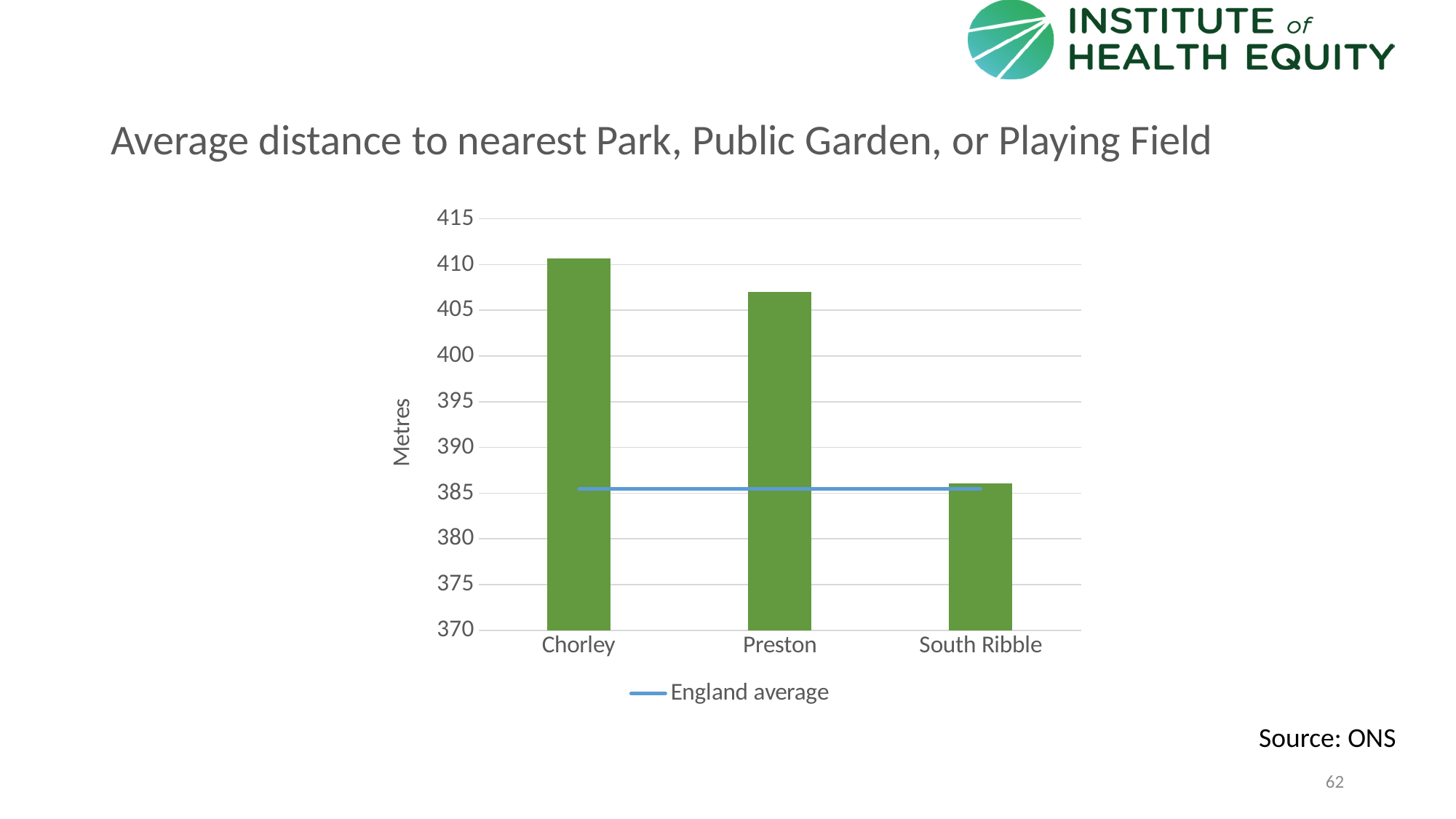
Do the bar values rise or fall moving from Chorley to South Ribble along the x axis? Fall Is the value for South Ribble greater or less than 390? less Which has the larger average distance, Preston or South Ribble? Preston How many local areas are plotted as bars in the chart? 3 Which area has the lowest average distance to the nearest park, public garden, or playing field? South Ribble Is the value for Preston greater or less than 410? less Is the value for Chorley greater or less than 405? greater What kind of chart is shown on the slide? Bar chart How many entries does the chart legend list? 1 What unit is shown on the vertical axis of the chart? Metres Which has the larger average distance, Chorley or Preston? Chorley Which area has the highest average distance to the nearest park, public garden, or playing field? Chorley